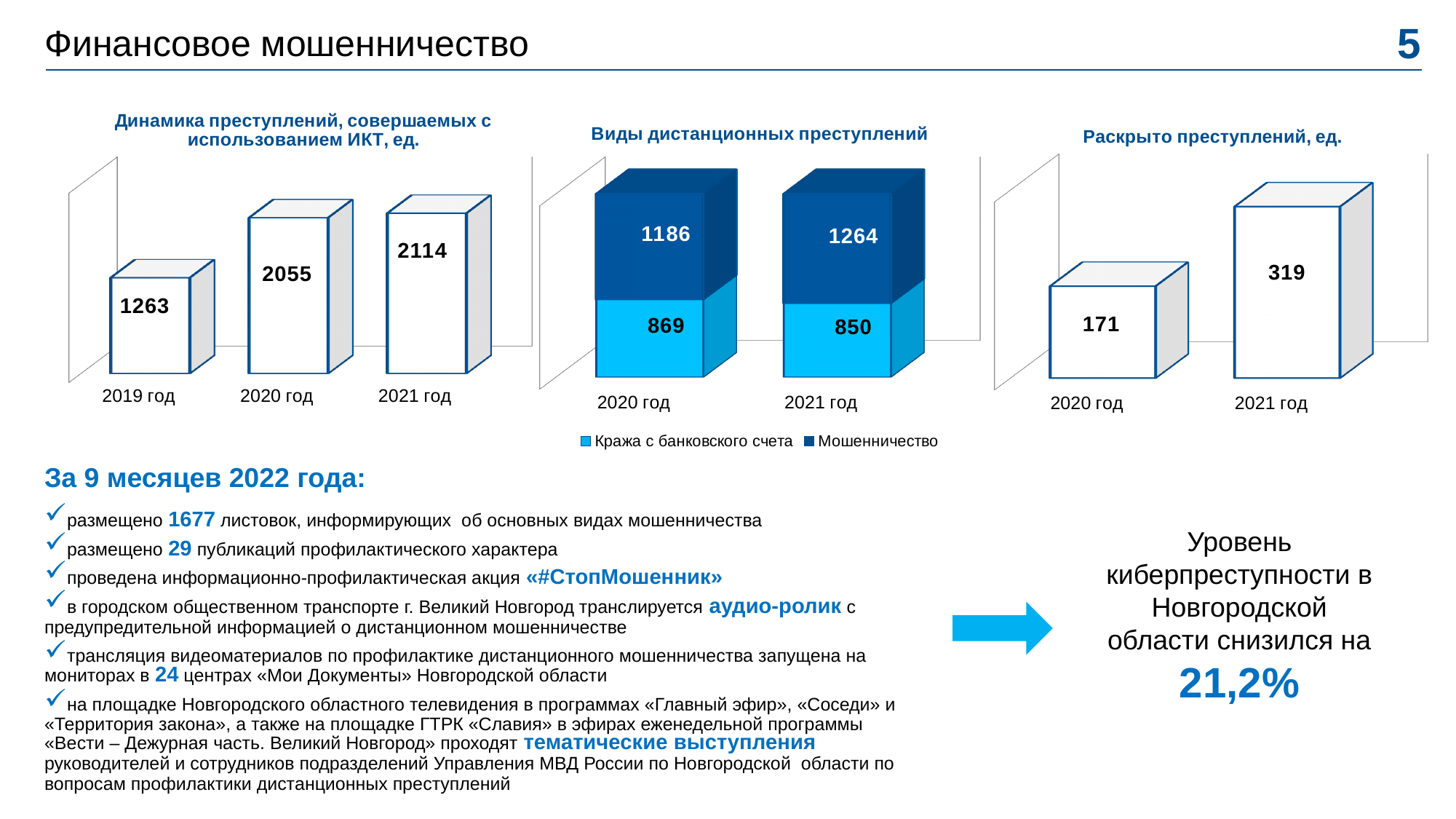
In the chart 'Динамика преступлений, совершаемых с использованием ИКТ, ед.', which year has the highest value? 2021 год In the chart 'Виды дистанционных преступлений', what is the value for Кража с банковского счета in 2020 год? 869 In the chart 'Раскрыто преступлений, ед.', what is the value for 2021 год? 319 In the chart 'Виды дистанционных преступлений', what is the total of the stacked bar for 2021 год? 2114 In the chart 'Раскрыто преступлений, ед.', what is the difference between the values for 2021 год and 2020 год? 148 In the chart 'Динамика преступлений, совершаемых с использованием ИКТ, ед.', what is the value for 2019 год? 1263 In the chart 'Виды дистанционных преступлений', which series is shown in light blue? Кража с банковского счета In the chart 'Динамика преступлений, совершаемых с использованием ИКТ, ед.', do the values rise or fall from 2019 год to 2021 год? rise In the chart 'Динамика преступлений, совершаемых с использованием ИКТ, ед.', what is the difference between the values for 2020 год and 2019 год? 792 In the chart 'Динамика преступлений, совершаемых с использованием ИКТ, ед.', how many years are shown? 3 In the chart 'Виды дистанционных преступлений', how many series does the legend list? 2 In the chart 'Виды дистанционных преступлений', what is the value for Мошенничество in 2021 год? 1264